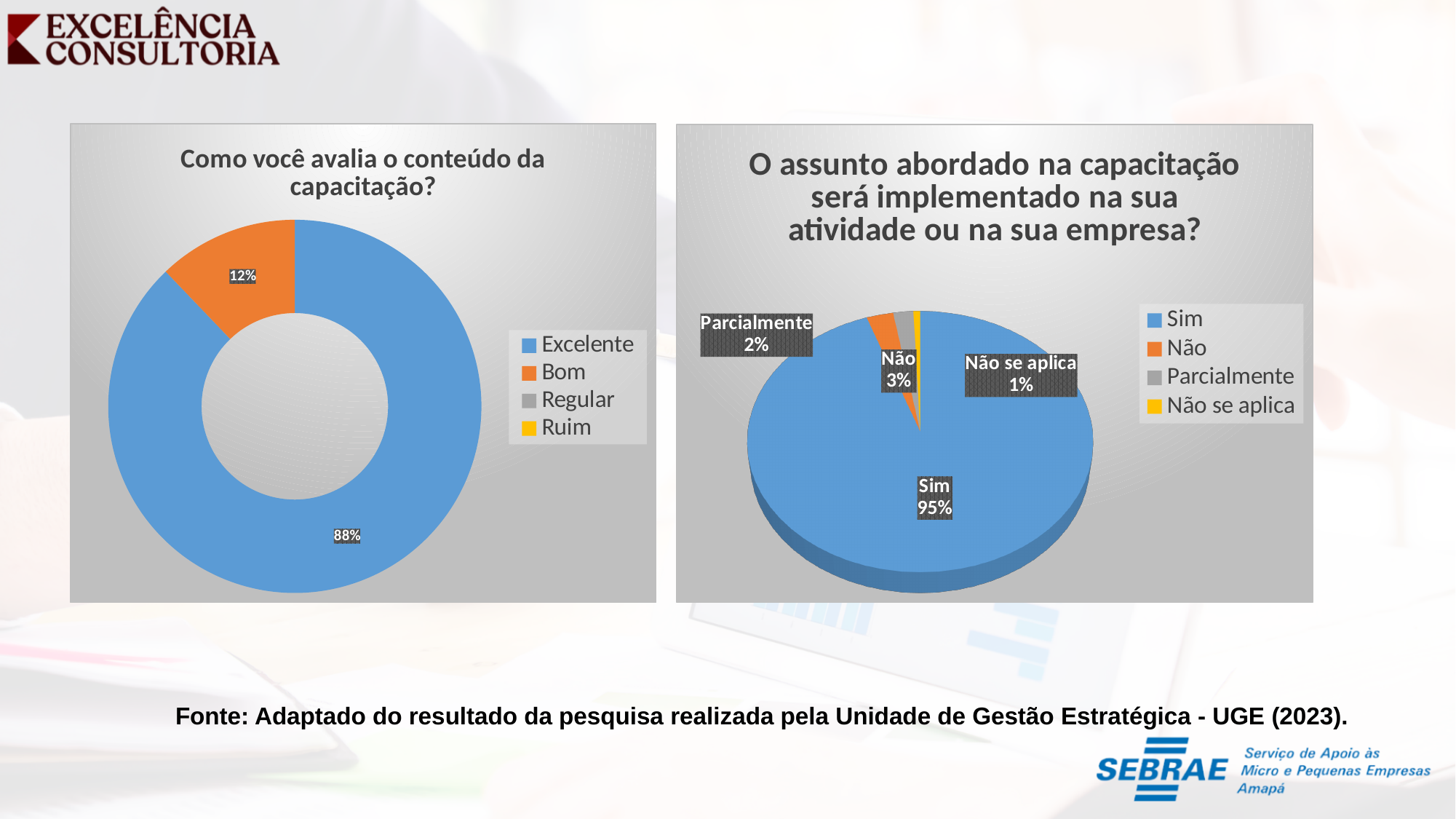
How many entries does the legend of the left chart 'Como você avalia o conteúdo da capacitação?' list? 4 In the right chart 'O assunto abordado na capacitação será implementado na sua atividade ou na sua empresa?', what share is labelled for Parcialmente? 2% What kind of chart is the left chart 'Como você avalia o conteúdo da capacitação?'? Doughnut chart In the left chart 'Como você avalia o conteúdo da capacitação?', which category has the largest share? Excelente In the right chart 'O assunto abordado na capacitação será implementado na sua atividade ou na sua empresa?', which category has the smallest share? Não se aplica In the right chart 'O assunto abordado na capacitação será implementado na sua atividade ou na sua empresa?', what share is labelled for Sim? 95% In the right chart 'O assunto abordado na capacitação será implementado na sua atividade ou na sua empresa?', what share is labelled for Não? 3% What kind of chart is the right chart 'O assunto abordado na capacitação será implementado na sua atividade ou na sua empresa?'? Pie chart In the left chart 'Como você avalia o conteúdo da capacitação?', what is the difference between the Excelente and Bom shares? 76% In the left chart 'Como você avalia o conteúdo da capacitação?', what share is labelled for Bom? 12% In the left chart 'Como você avalia o conteúdo da capacitação?', what share is labelled for Excelente? 88% In the right chart 'O assunto abordado na capacitação será implementado na sua atividade ou na sua empresa?', which is larger, Não or Parcialmente? Não